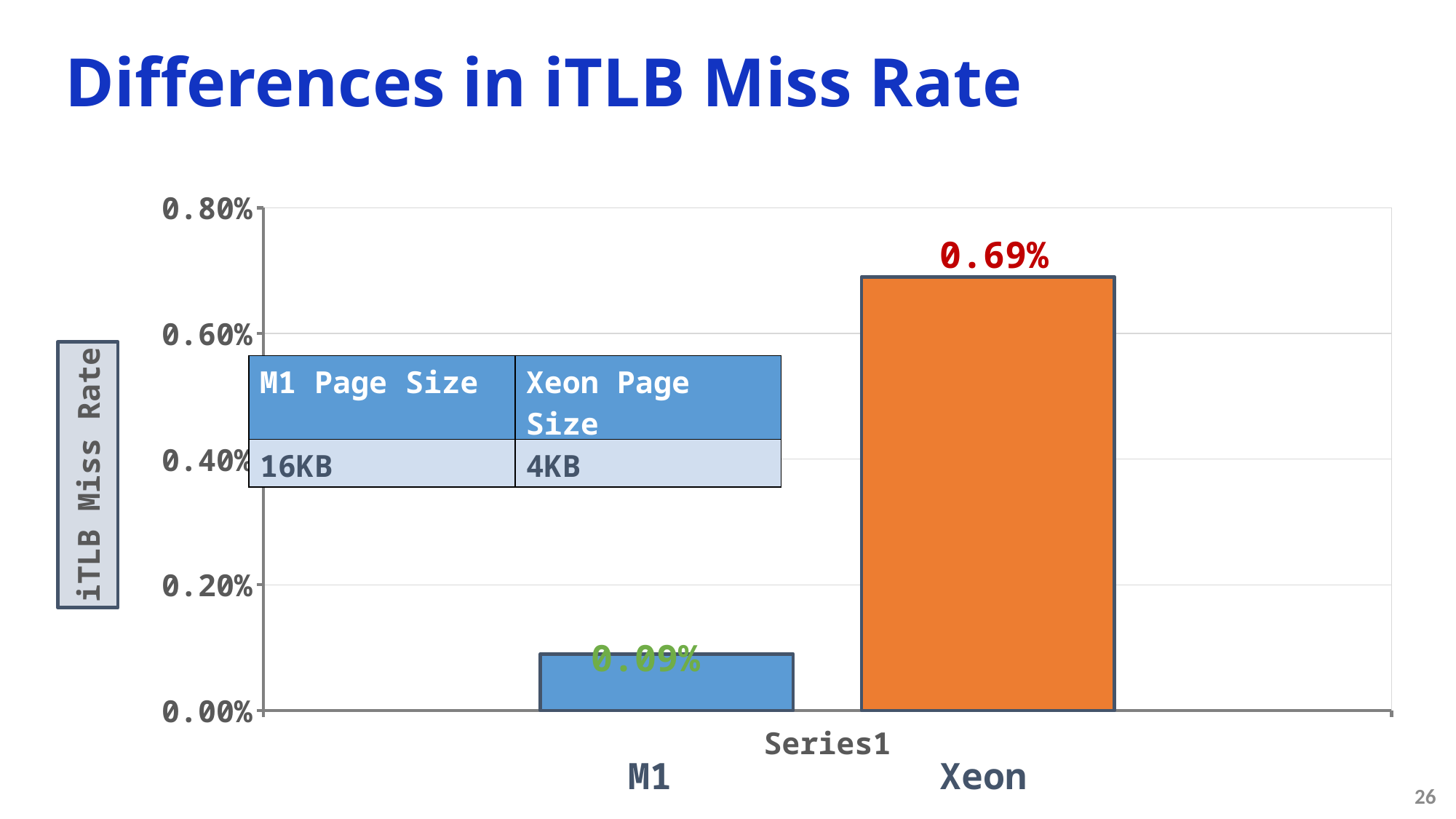
What is the label on the vertical axis of the chart? iTLB Miss Rate Is the iTLB miss rate for M1 greater or less than 0.20%? less Is the iTLB miss rate for Xeon greater or less than 0.60%? greater How many processors are compared in the chart? 2 What is the iTLB miss rate for Xeon? 0.69% What is the difference between the Xeon and M1 iTLB miss rates? 0.60% What kind of chart is shown on the slide? bar chart Which processor has the higher iTLB miss rate? Xeon What is the iTLB miss rate for M1? 0.09% Is the iTLB miss rate for M1 larger or smaller than that for Xeon? smaller Which processor has the lower iTLB miss rate? M1 What is the title of the slide? Differences in iTLB Miss Rate